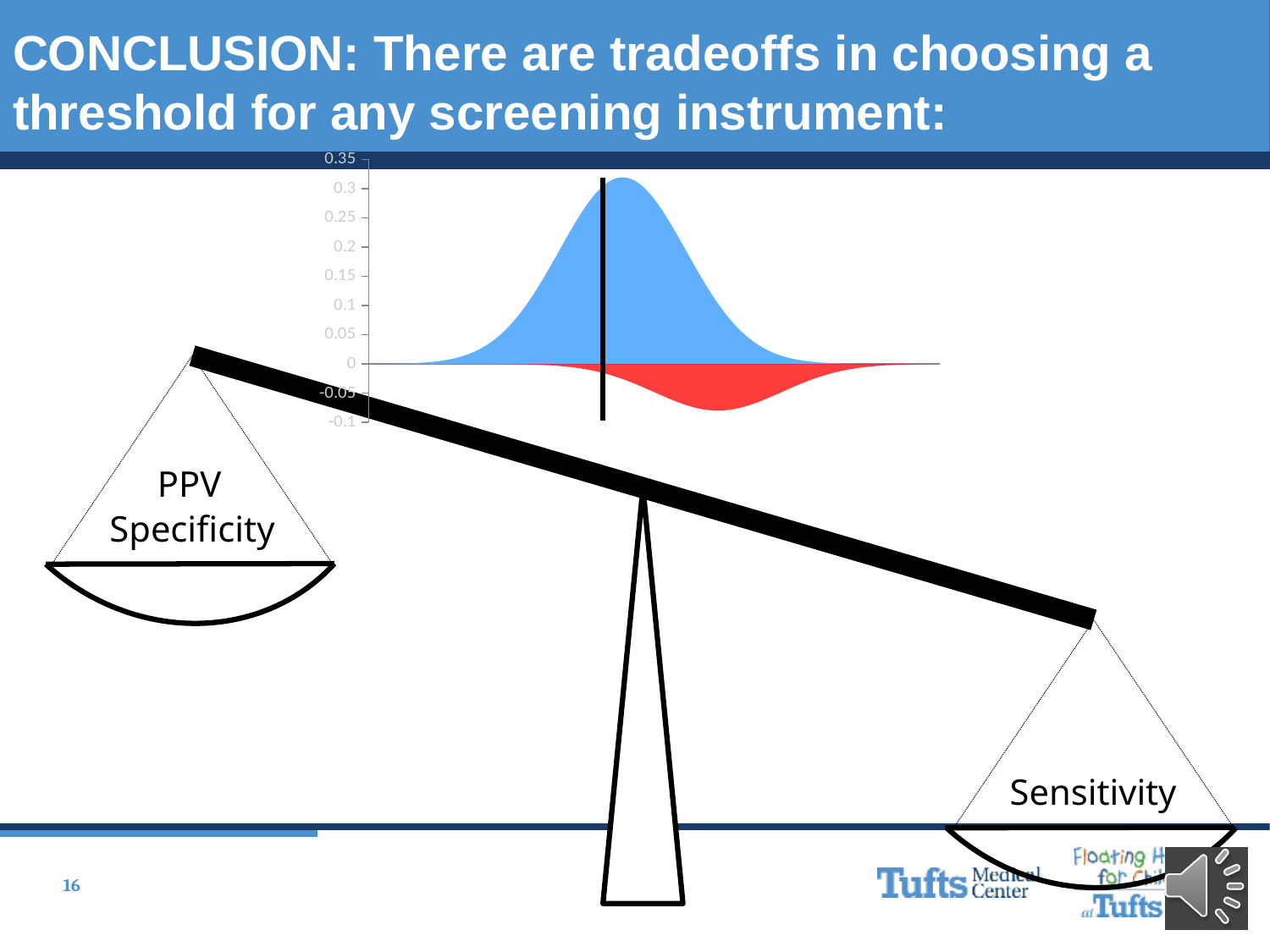
Which filled area reaches farther from the zero line, the blue one or the red one? the blue one Is the lowest point of the red area greater or less than -0.1? greater How many filled areas are plotted in the chart? 2 What is the lowest value shown on the vertical axis of the chart? -0.1 Is the peak of the blue area greater or less than 0.35? less What is the highest value shown on the vertical axis of the chart? 0.35 Is the peak of the blue area greater or less than 0.25? greater Which filled area lies above the zero line, the blue one or the red one? the blue one What kind of chart is shown on the slide? area chart